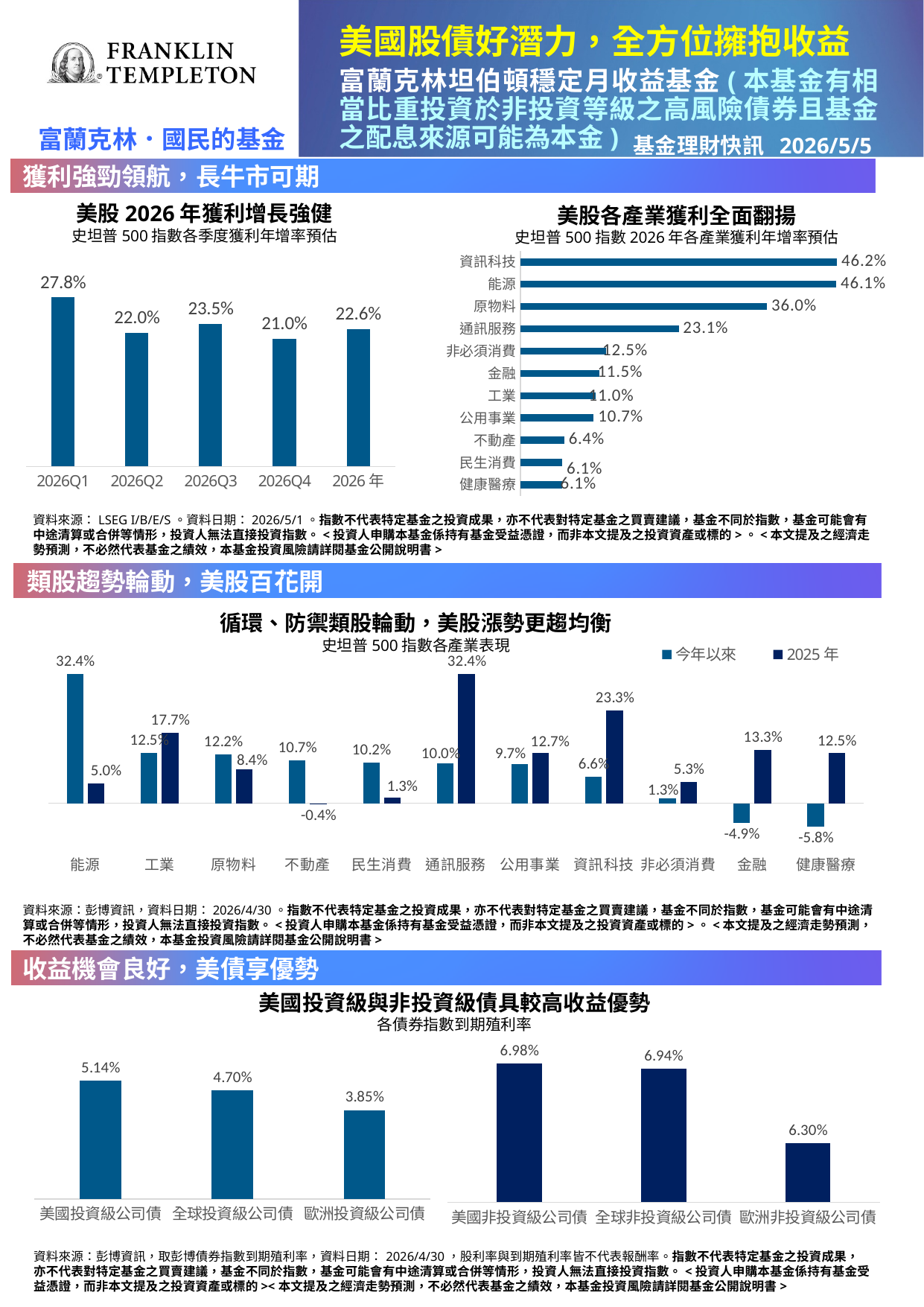
In the chart titled 美股 2026 年獲利增長強健, what is the value for 2026Q1? 27.8% In the chart titled 循環、防禦類股輪動，美股漲勢更趨均衡, which is larger for 能源: 今年以來 or 2025 年? 今年以來 In the chart titled 美國投資級與非投資級債具較高收益優勢, what is the difference between 美國非投資級公司債 and 美國投資級公司債? 1.84% In the chart titled 循環、防禦類股輪動，美股漲勢更趨均衡, how many series does the legend list? 2 In the chart titled 美股各產業獲利全面翻揚, what kind of chart is it? Bar chart In the chart titled 美股各產業獲利全面翻揚, which industry has the highest value? 資訊科技 In the chart titled 美股 2026 年獲利增長強健, how many bars are plotted? 5 In the chart titled 美股各產業獲利全面翻揚, what is the difference between 通訊服務 and 金融? 11.6% In the chart titled 循環、防禦類股輪動，美股漲勢更趨均衡, what is the 2025 年 value for 資訊科技? 23.3% In the chart titled 美股各產業獲利全面翻揚, what is the value for 原物料? 36.0% In the chart titled 美股 2026 年獲利增長強健, which quarter has the lowest value? 2026Q4 In the chart titled 美國投資級與非投資級債具較高收益優勢, what is the value for 歐洲非投資級公司債? 6.30%